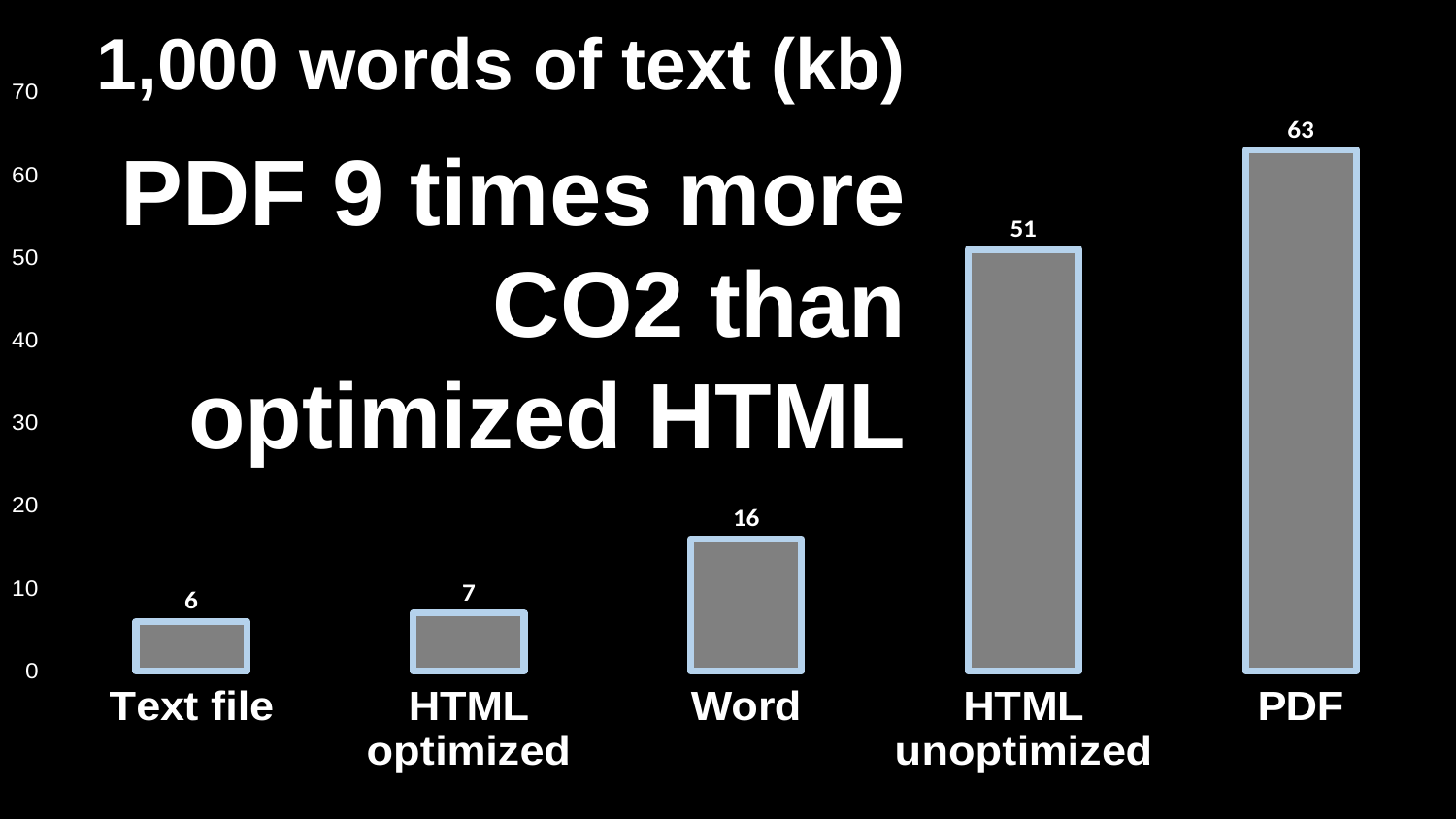
Which category has the highest value? PDF What kind of chart is shown on the slide? Bar chart What is the difference between the values for PDF and HTML optimized? 56 What is the value for HTML unoptimized? 51 What is the title of the chart? 1,000 words of text (kb) What is the value for Text file? 6 Which is larger, the value for Word or the value for HTML optimized? Word What is the value for PDF? 63 What is the difference between the values for HTML unoptimized and Word? 35 How many categories are shown in the chart? 5 Which category has the lowest value? Text file What is the value for Word? 16